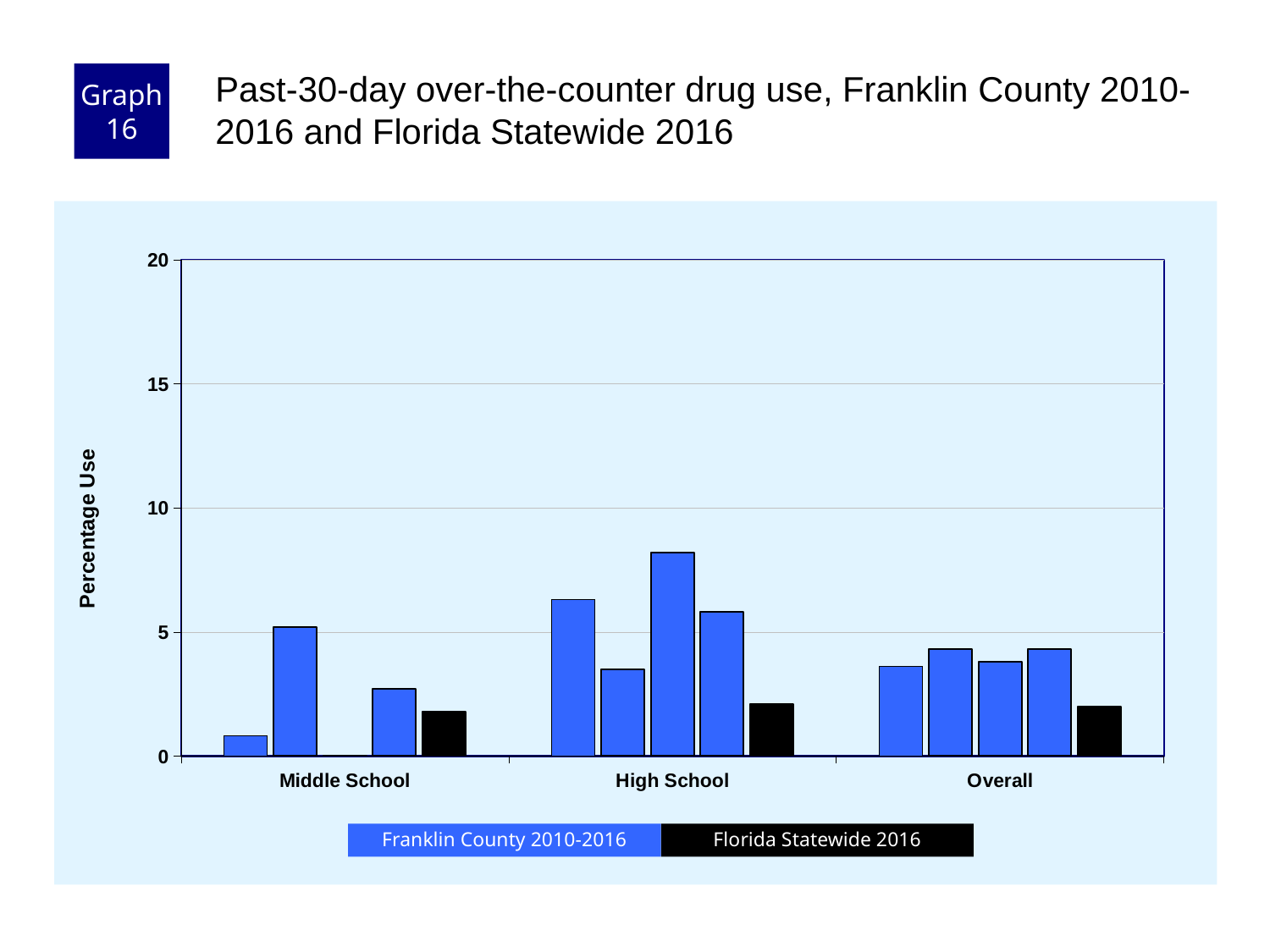
Is the tallest bar in the High School group greater or less than 10? less What is the label on the y axis? Percentage Use Is the Florida Statewide 2016 value for Middle School greater or less than 5? less Is the Florida Statewide 2016 value for Overall greater or less than 5? less Which category contains the tallest bar in the chart? High School Which is larger: the tallest bar in the High School group or the tallest bar in the Middle School group? High School Which series is shown in black in the legend? Florida Statewide 2016 How many categories are shown on the x axis? 3 What kind of chart is shown on the slide? bar chart How many series does the legend list? 2